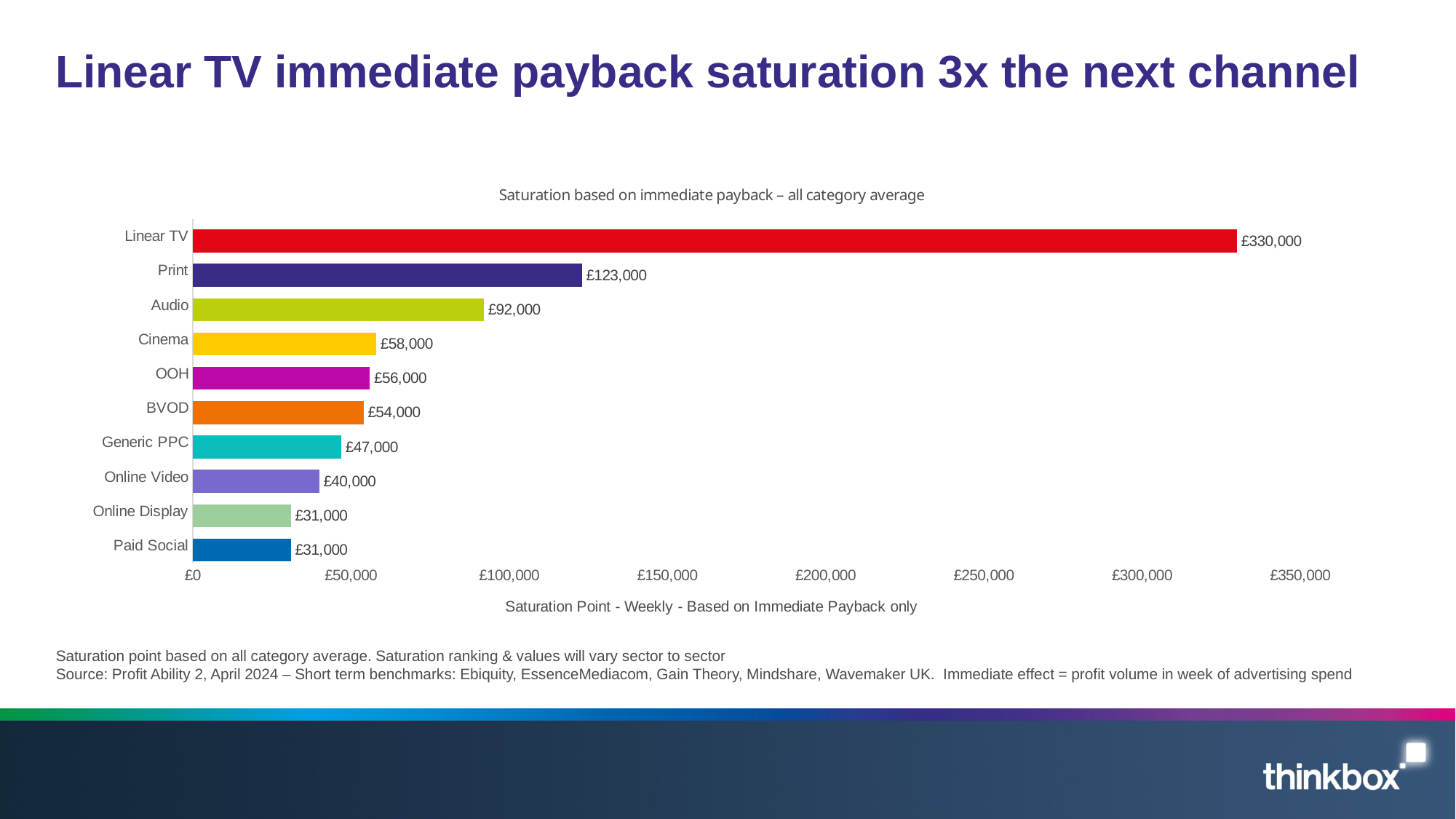
What is the saturation point for Generic PPC? £47,000 What colour is the bar for Linear TV? Red What is the difference between the saturation points of Cinema and OOH? £2,000 What is the saturation point for Audio? £92,000 What is the difference between the saturation points of Linear TV and Print? £207,000 Is the value for BVOD greater or less than £50,000? greater What kind of chart is shown on the slide? Bar chart Which channel has the highest saturation point? Linear TV What is the saturation point for Linear TV? £330,000 How many channels are shown in the chart? 10 What is the title of the chart? Saturation based on immediate payback – all category average Which has a larger saturation point, Print or Audio? Print